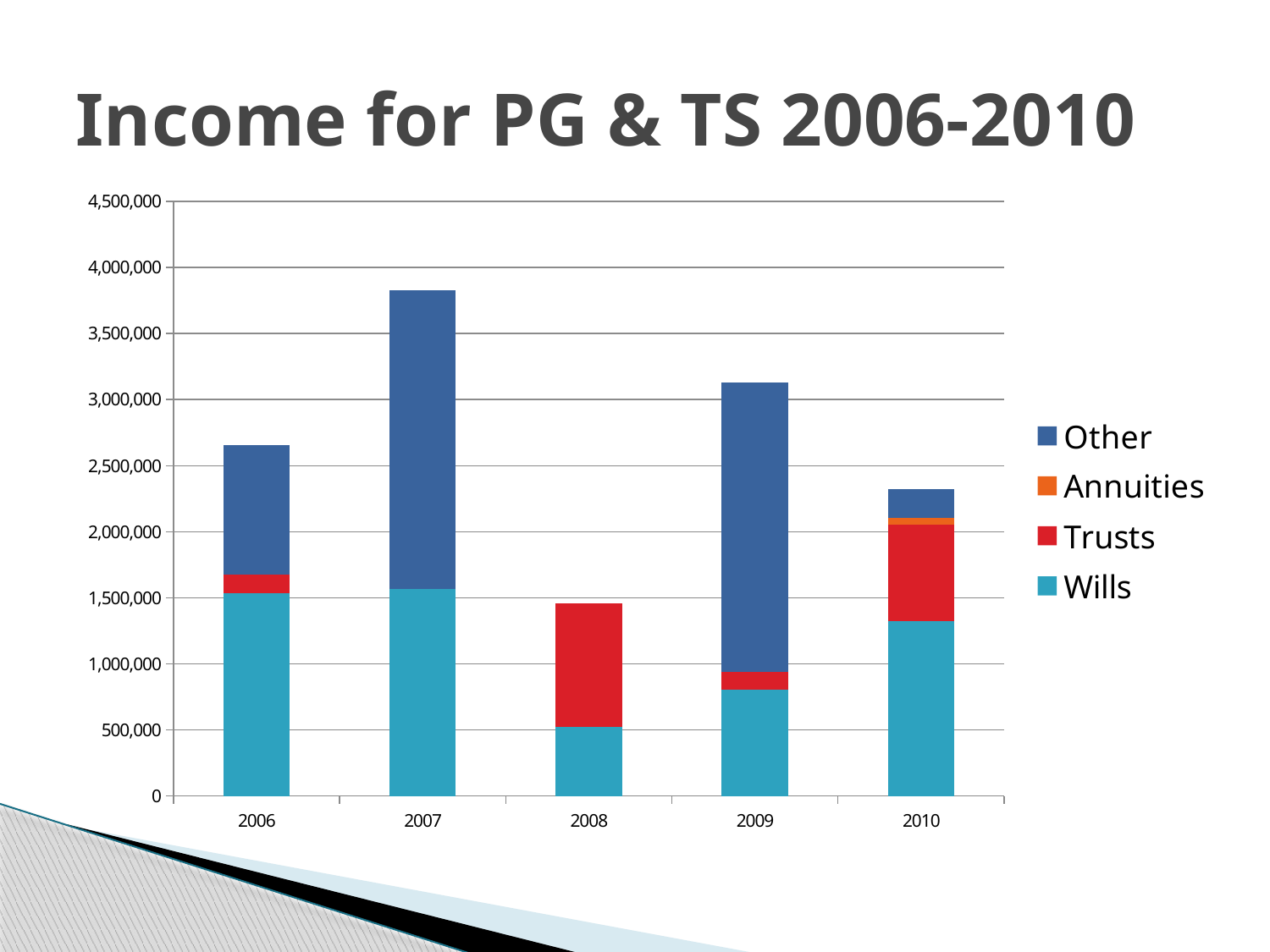
Is the Wills value for 2008 greater or less than 1,000,000? less What kind of chart is shown on the slide? Stacked bar chart Is the total income for 2008 greater or less than 1,500,000? less Is the total income for 2010 greater or less than 2,000,000? greater In which year is the Annuities segment visible in the bar? 2010 Which year has the lowest total income? 2008 How many series does the legend list? 4 Which year has the smallest Wills segment? 2008 How many years are shown on the x axis? 5 Which year has the highest total income? 2007 Which year has the larger total income, 2006 or 2009? 2009